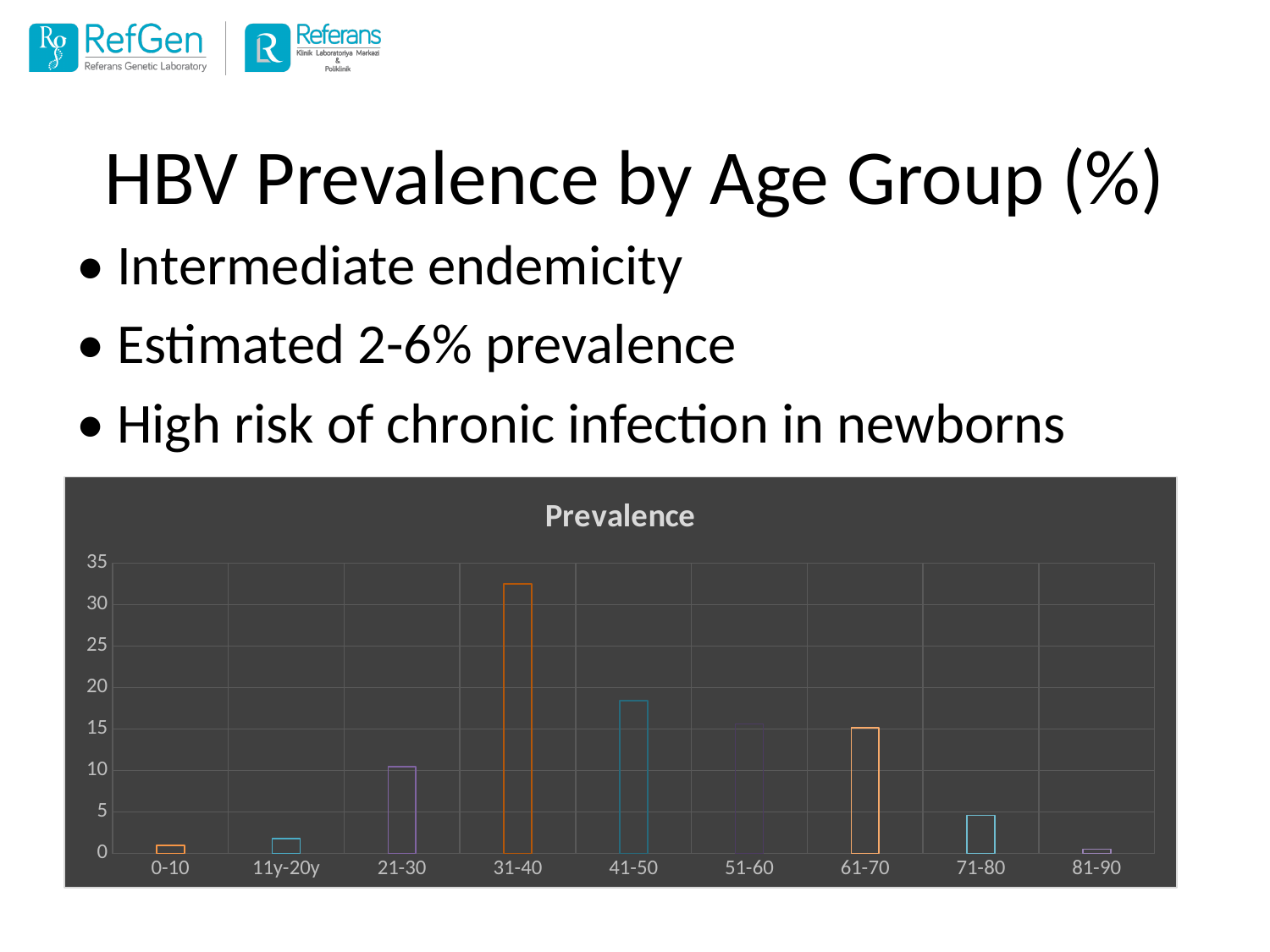
Is the value for the 61-70 age group greater or less than 10? greater Do the values rise or fall from the 0-10 age group to the 31-40 age group? rise Which has a higher prevalence, the 31-40 age group or the 41-50 age group? 31-40 What is the title of the chart? Prevalence Which has a higher prevalence, the 21-30 age group or the 71-80 age group? 21-30 Is the value for the 31-40 age group greater or less than 30? greater What kind of chart is shown on the slide? bar chart Which age group has the highest prevalence in the chart? 31-40 Is the value for the 41-50 age group greater or less than 15? greater How many age-group categories are shown on the x axis of the chart? 9